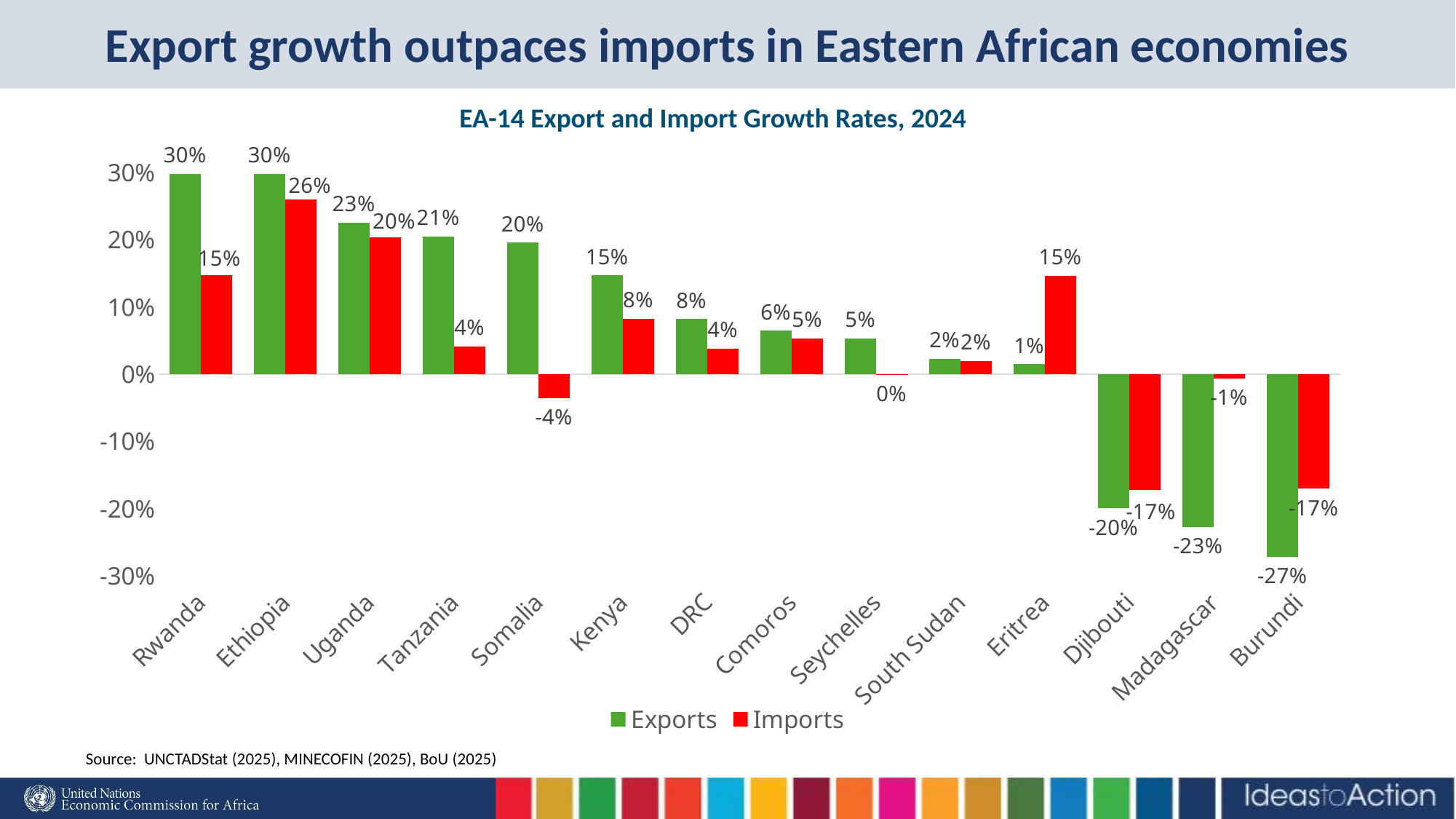
What is the import growth rate for Eritrea? 15% What is the import growth rate for Somalia? -4% What is the difference between Tanzania's export growth rate and its import growth rate? 17 percentage points What is the export growth rate for Madagascar? -23% How many countries are shown on the x axis? 14 Which country has the lowest export growth rate? Burundi Which colour represents Imports in the chart? Red What is the export growth rate for Uganda? 23% What kind of chart is shown on the slide? Bar chart How many series does the legend list? 2 Which is larger for Eritrea, the export growth rate or the import growth rate? Import growth rate Which country has the highest import growth rate? Ethiopia